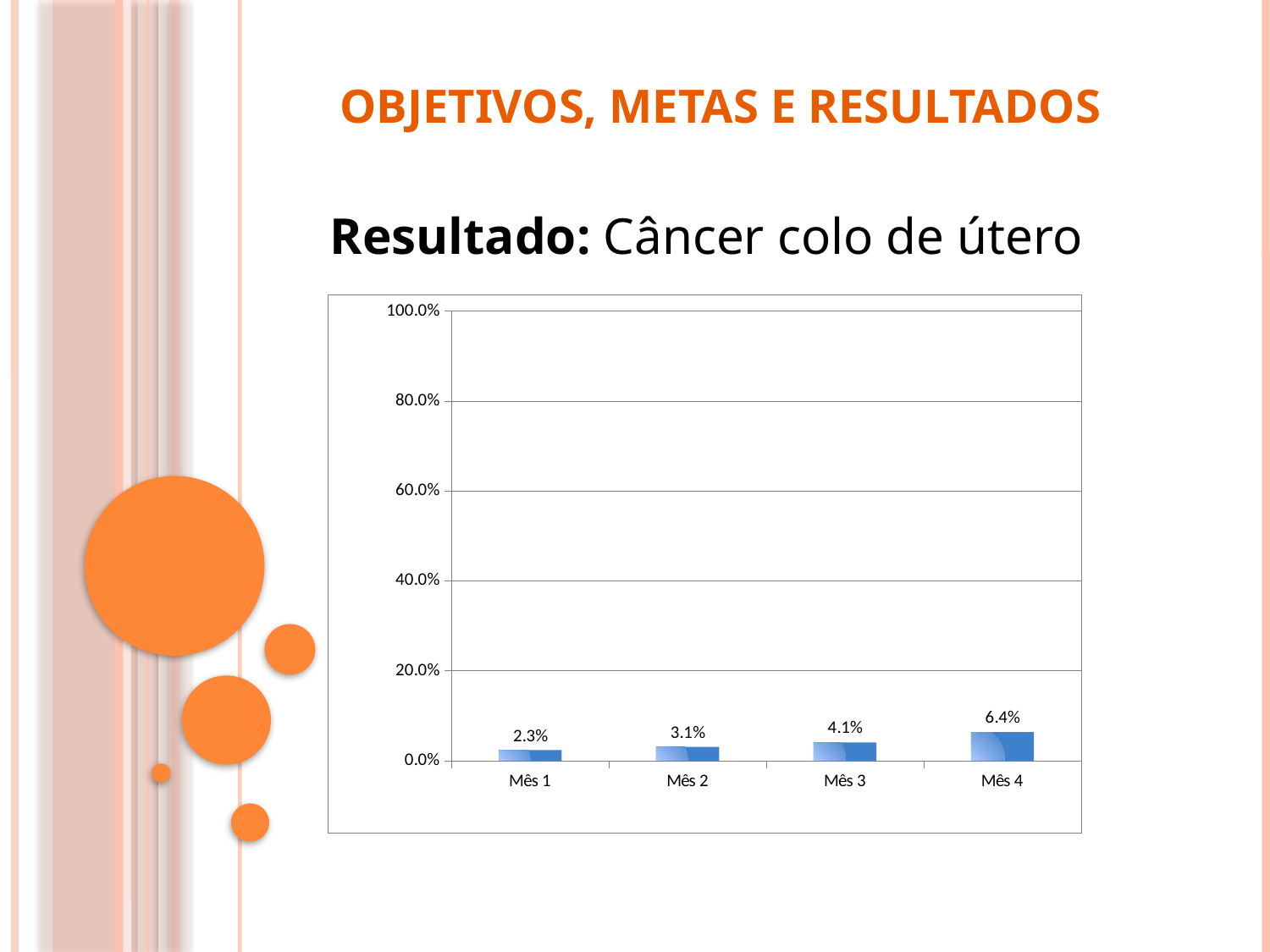
What is the difference between the values for Mês 4 and Mês 1? 4.1% What kind of chart is shown on the slide? Bar chart Which is larger, the value for Mês 2 or the value for Mês 3? Mês 3 Which month has the lowest value? Mês 1 How many months are shown on the x axis? 4 What is the value for Mês 1? 2.3% What is the value for Mês 4? 6.4% What is the difference between the values for Mês 3 and Mês 2? 1.0% What is the value for Mês 3? 4.1% Is the value for Mês 4 greater or less than 20.0%? less Which month has the highest value? Mês 4 What is the value for Mês 2? 3.1%